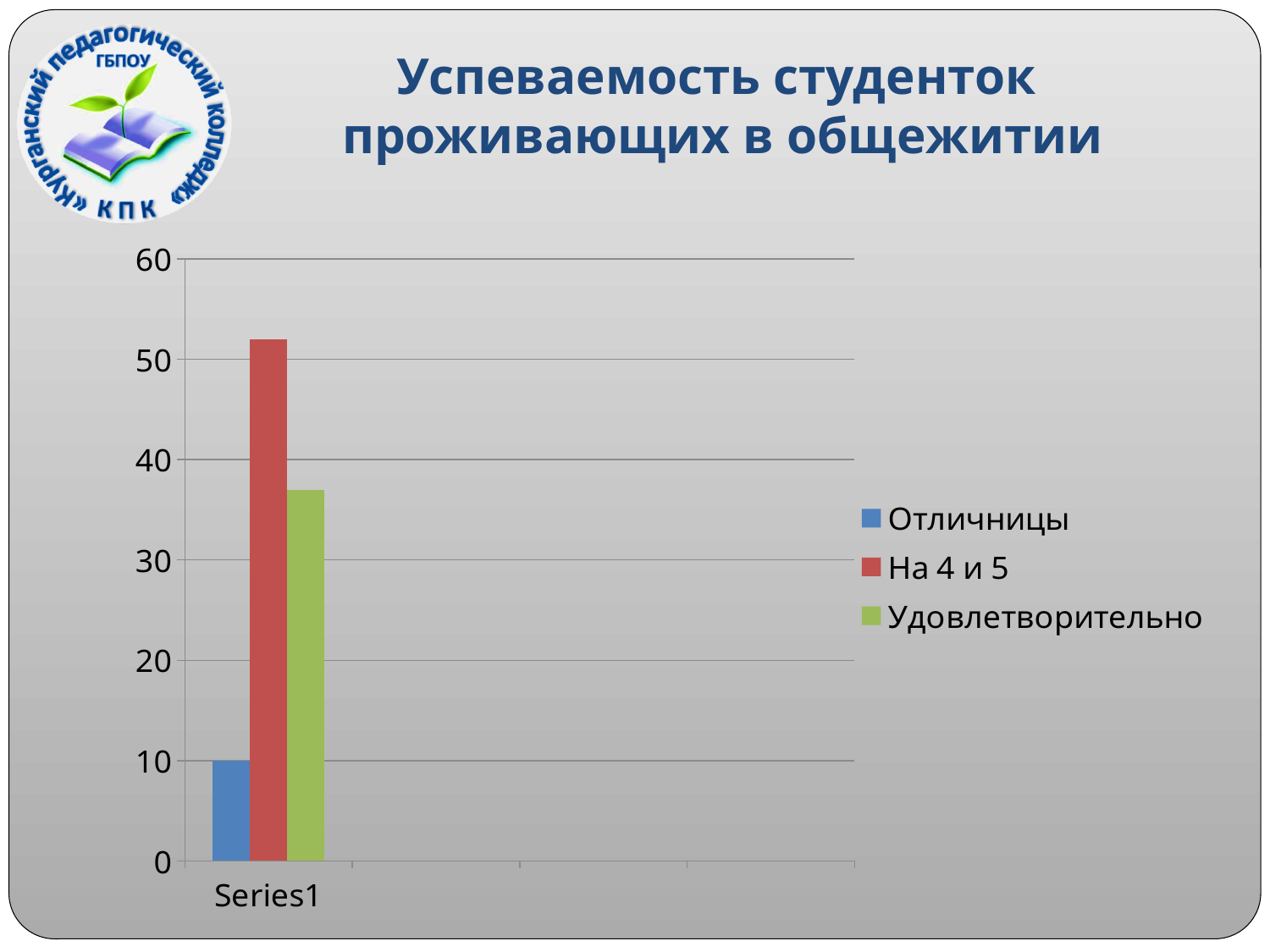
What is the title of the chart? Успеваемость студенток проживающих в общежитии Is the value for На 4 и 5 greater or less than 50? greater Is the value for Отличницы greater or less than 20? less What kind of chart is shown on the slide? bar chart Which is larger, the value for Отличницы or the value for Удовлетворительно? Удовлетворительно Is the value for Удовлетворительно greater or less than 40? less Which series has the highest bar? На 4 и 5 Which is larger, the value for На 4 и 5 or the value for Удовлетворительно? На 4 и 5 What colour is the bar for На 4 и 5? red Which series has the lowest bar? Отличницы How many series does the legend list? 3